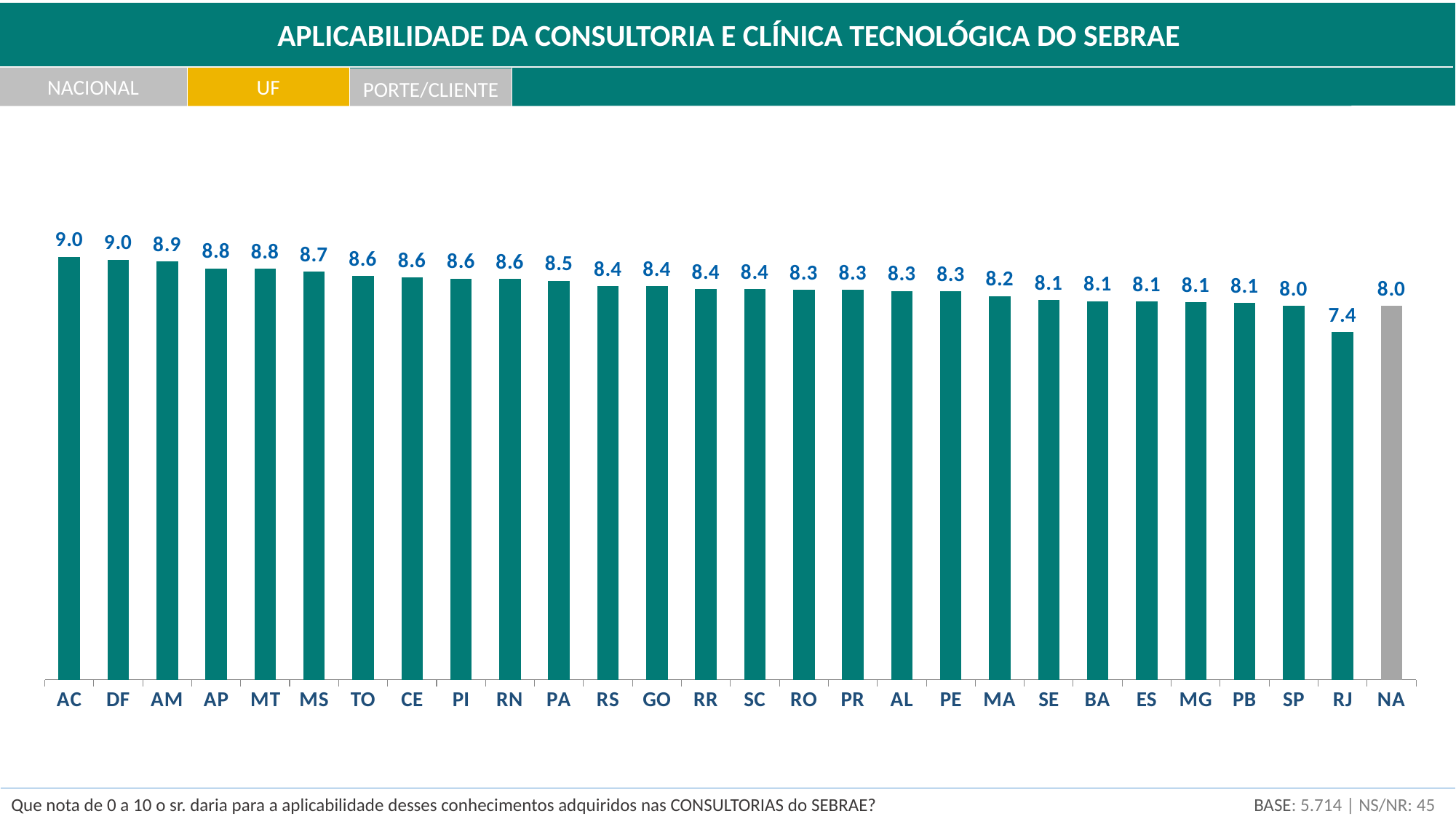
Which bar is shown in grey rather than teal? NA Which category has the lowest value? RJ What is the value for RJ? 7.4 What is the difference between the values for AC and RJ? 1.6 What is the value for NA? 8.0 What kind of chart is shown on the slide? bar chart What is the value for MA? 8.2 Which is larger, the value for RJ or the value for SP? SP How many bars are shown in the chart? 28 Which is larger, the value for AP or the value for PA? AP What is the value for MS? 8.7 What is the difference between the values for AM and SP? 0.9